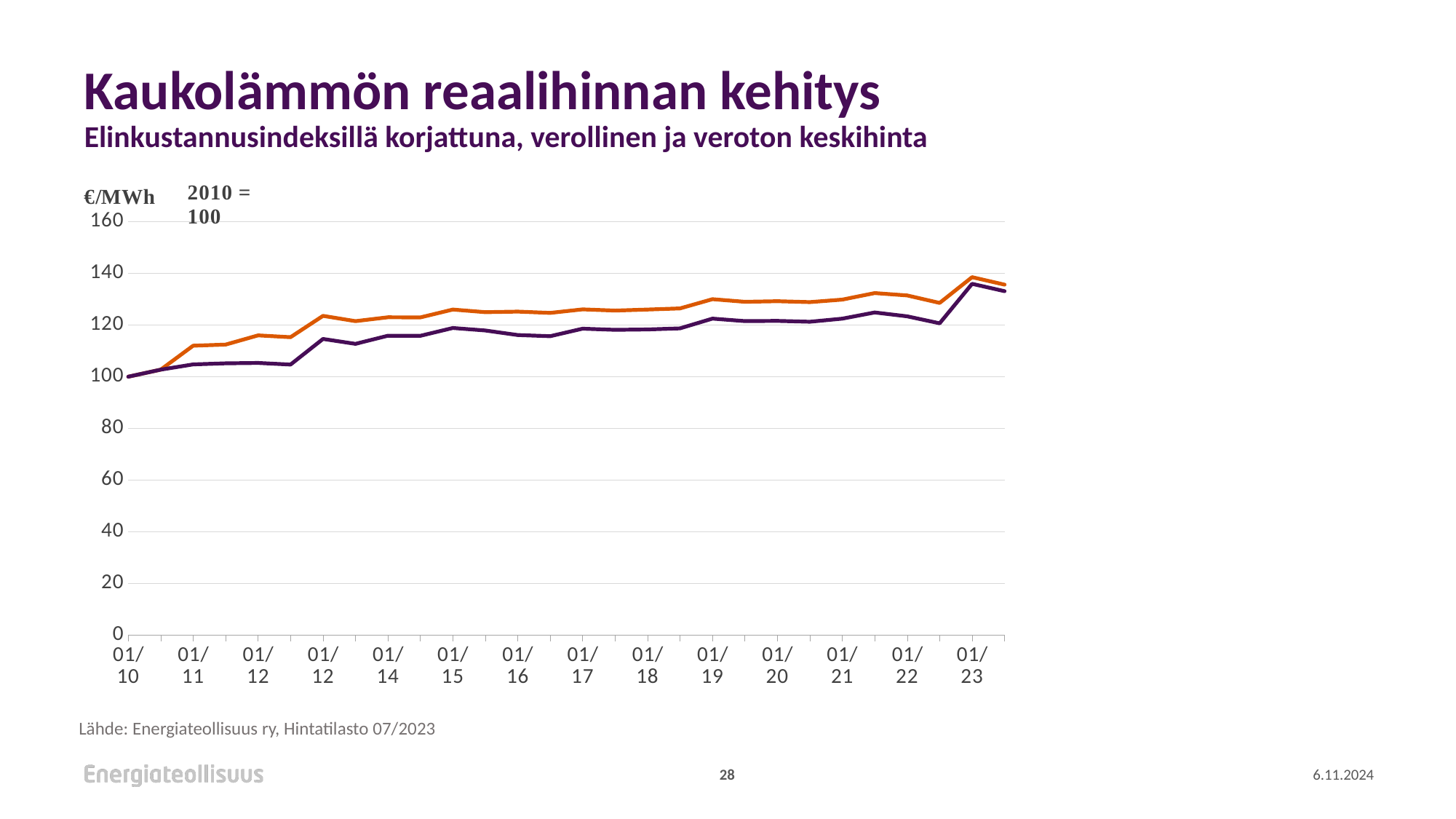
How many lines are plotted on the chart? 2 How many labelled points are there along the x axis? 14 Is the value of the purple line at 01/23 greater or less than 120? greater Do the values of the purple line generally rise or fall from 01/10 to 01/23? rise Is the value of the purple line at 01/11 greater or less than 120? less What unit is shown on the y axis of the chart? €/MWh What kind of chart is shown on the slide? line chart At 01/23, which line has the higher value, the orange line or the purple line? the orange line Is the value of the orange line at 01/23 greater or less than 120? greater At which x-axis label does the orange line reach its highest value? 01/23 What is the value of both lines at 01/10? 100